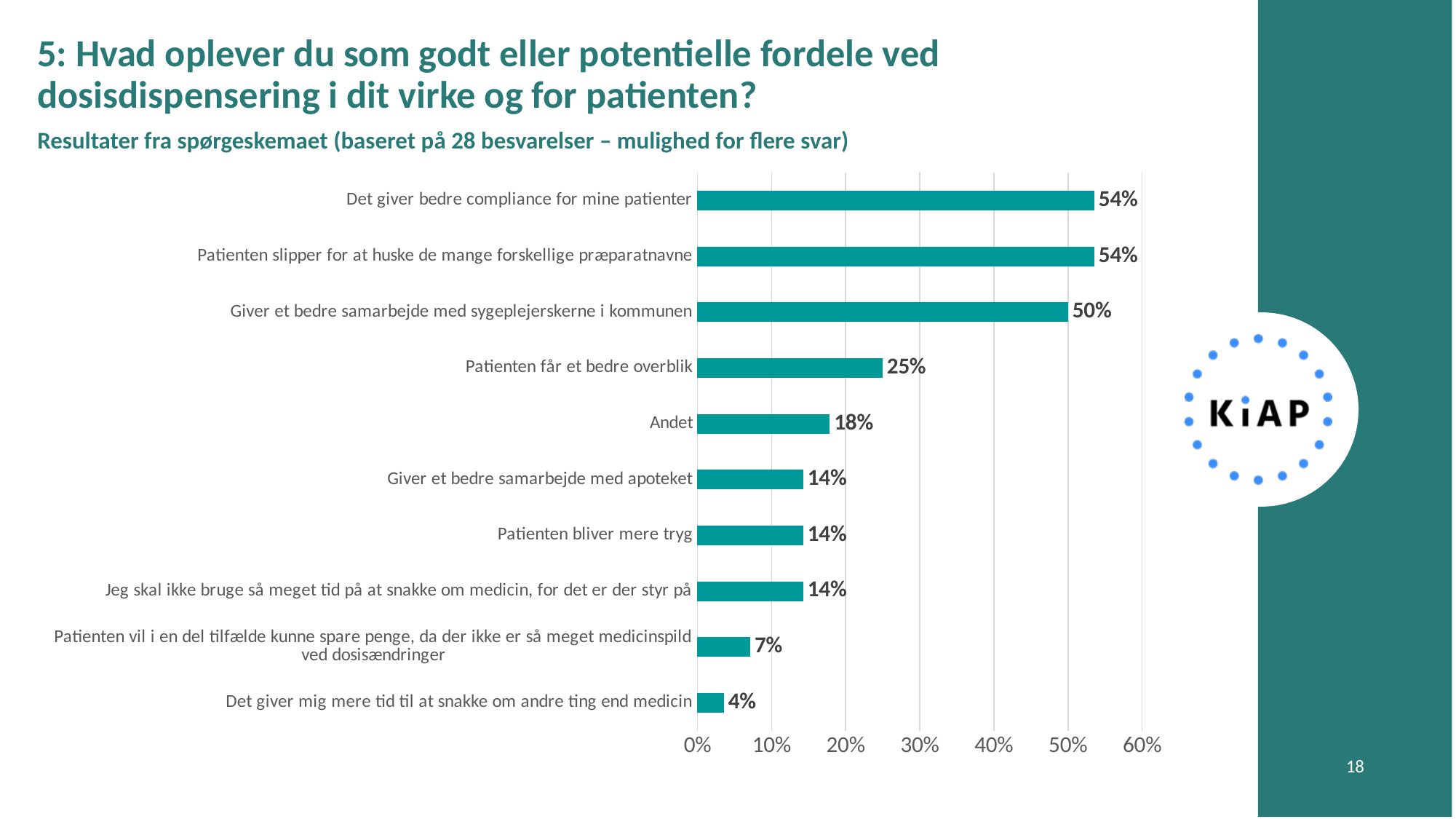
What is the difference between the values for "Det giver bedre compliance for mine patienter" and "Giver et bedre samarbejde med sygeplejerskerne i kommunen"? 4% Which category has the lowest value? Det giver mig mere tid til at snakke om andre ting end medicin What is the value for "Giver et bedre samarbejde med sygeplejerskerne i kommunen"? 50% Which is larger: the value for "Patienten får et bedre overblik" or the value for "Giver et bedre samarbejde med apoteket"? Patienten får et bedre overblik What kind of chart is shown on the slide? bar chart How many categories are shown in the chart? 10 Is the value for "Giver et bedre samarbejde med sygeplejerskerne i kommunen" greater or less than 40%? greater What is the value for "Patienten får et bedre overblik"? 25% What is the difference between the values for "Patienten får et bedre overblik" and "Andet"? 7% What is the value for "Det giver mig mere tid til at snakke om andre ting end medicin"? 4% What is the value for "Andet"? 18% How many responses is the chart based on, according to the subtitle? 28